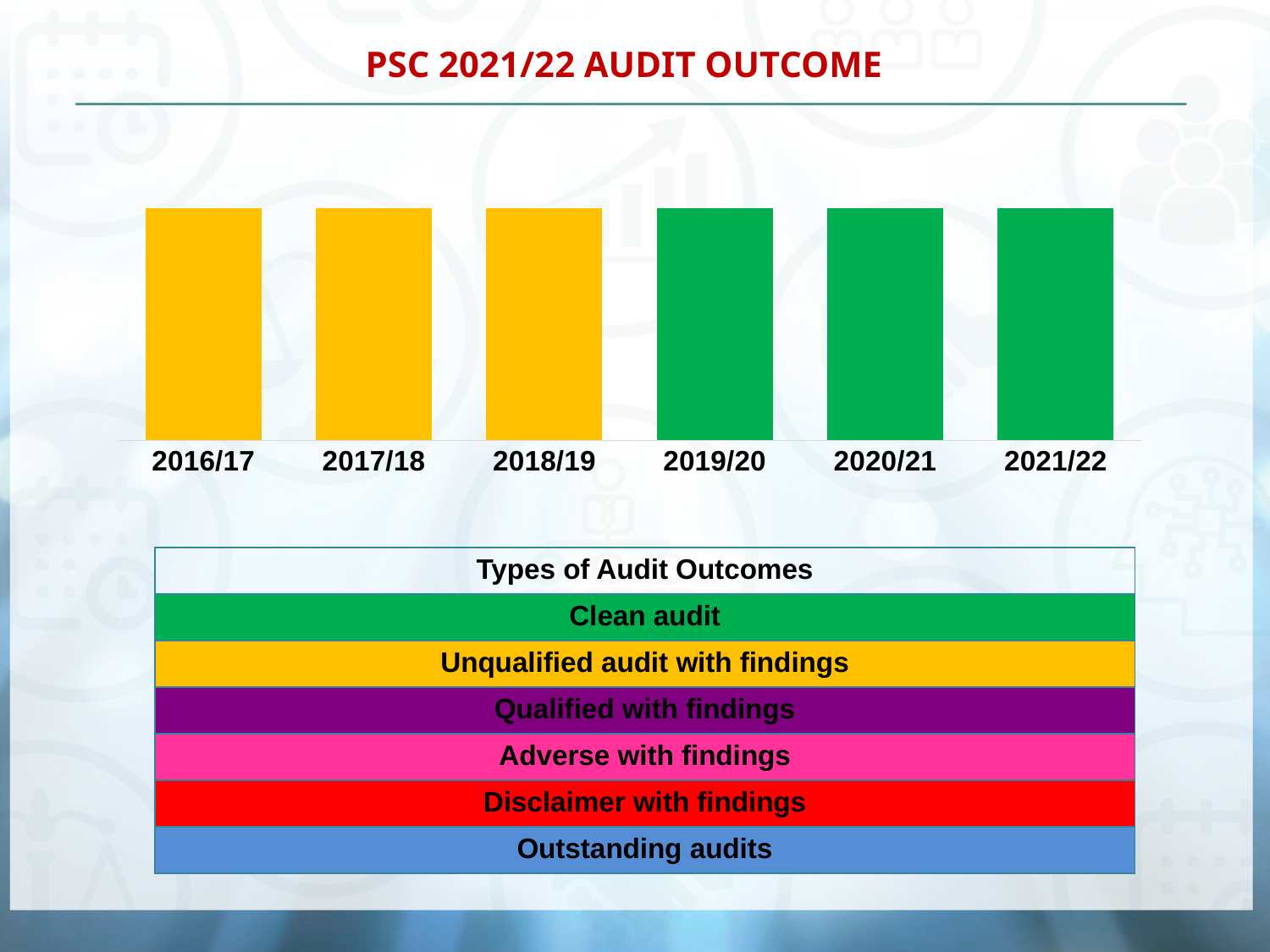
What audit outcome does the colour of the 2016/17 bar represent according to the legend? Unqualified audit with findings What audit outcome does the colour of the 2021/22 bar represent according to the legend? Clean audit What is the title of the slide containing the chart? PSC 2021/22 AUDIT OUTCOME What kind of chart is shown on the slide? bar chart How many types of audit outcomes are listed in the legend table below the chart? 6 How many financial years are shown on the x axis of the chart? 6 What colour is used in the legend for 'Disclaimer with findings'? red Which is the first financial year shown with a clean audit (green bar)? 2019/20 How many of the years shown have an unqualified audit with findings (yellow bar)? 3 How many of the years shown have a clean audit (green bar)? 3 Do the bar heights rise, fall, or stay the same across the years on the x axis? stay the same Which is the last financial year shown with an unqualified audit with findings (yellow bar)? 2018/19